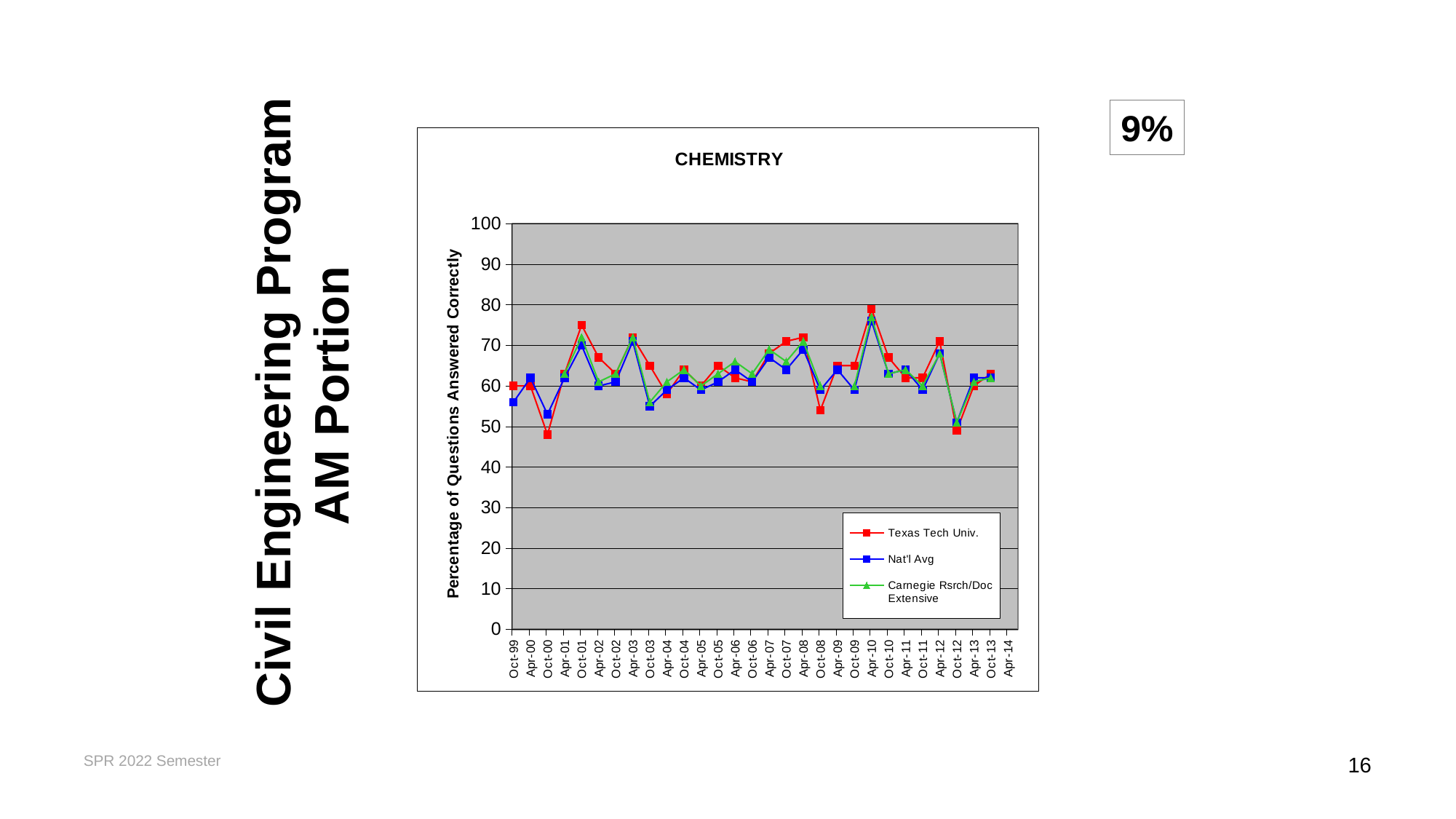
At Oct-08, which is larger: the Texas Tech Univ. value or the Nat'l Avg value? Nat'l Avg Is the value for Texas Tech Univ. at Oct-00 greater or less than 50? less At which date does the Texas Tech Univ. series reach its highest value? Apr-10 What kind of chart is shown on the slide? line chart Is the value for Texas Tech Univ. at Oct-01 greater or less than 70? greater How many series does the legend of the CHEMISTRY chart list? 3 Is the value for Texas Tech Univ. at Oct-08 greater or less than 60? less What is the title of the chart? CHEMISTRY What is the label on the vertical axis of the chart? Percentage of Questions Answered Correctly At Oct-00, which is larger: the Texas Tech Univ. value or the Nat'l Avg value? Nat'l Avg